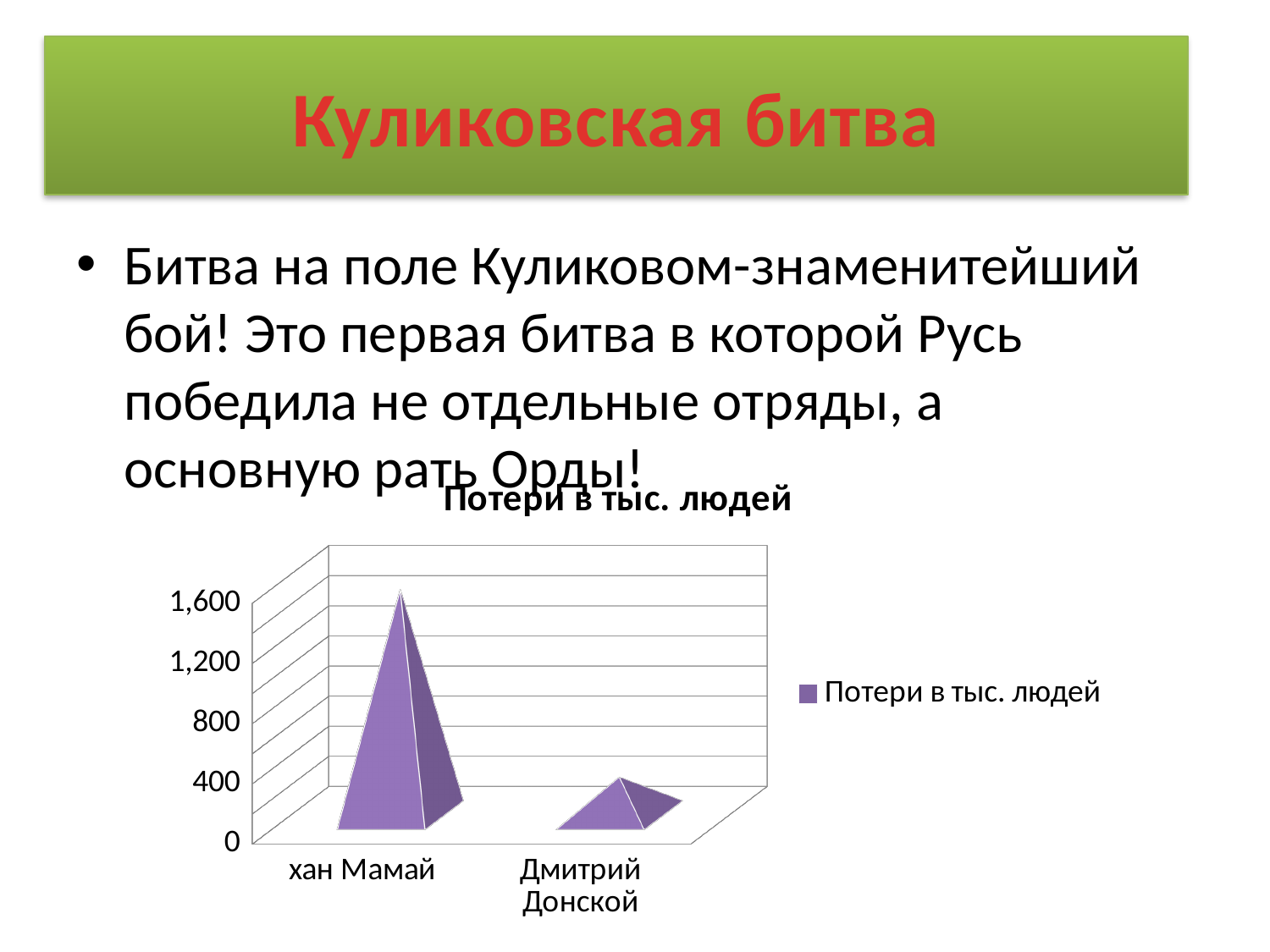
What is the title of the chart? Потери в тыс. людей Which category has the lowest value in the chart? Дмитрий Донской Which category has the highest value in the chart? хан Мамай Is the value for хан Мамай greater or less than 1,200? greater Is the value for Дмитрий Донской greater or less than 800? less What kind of chart is shown on the slide? bar chart Do the values rise or fall from хан Мамай to Дмитрий Донской along the x axis? fall Is the value for хан Мамай greater or less than 800? greater How many series does the chart legend list? 1 Which is larger, the value for хан Мамай or the value for Дмитрий Донской? хан Мамай What is the legend entry of the chart? Потери в тыс. людей How many categories are shown on the x axis of the chart? 2